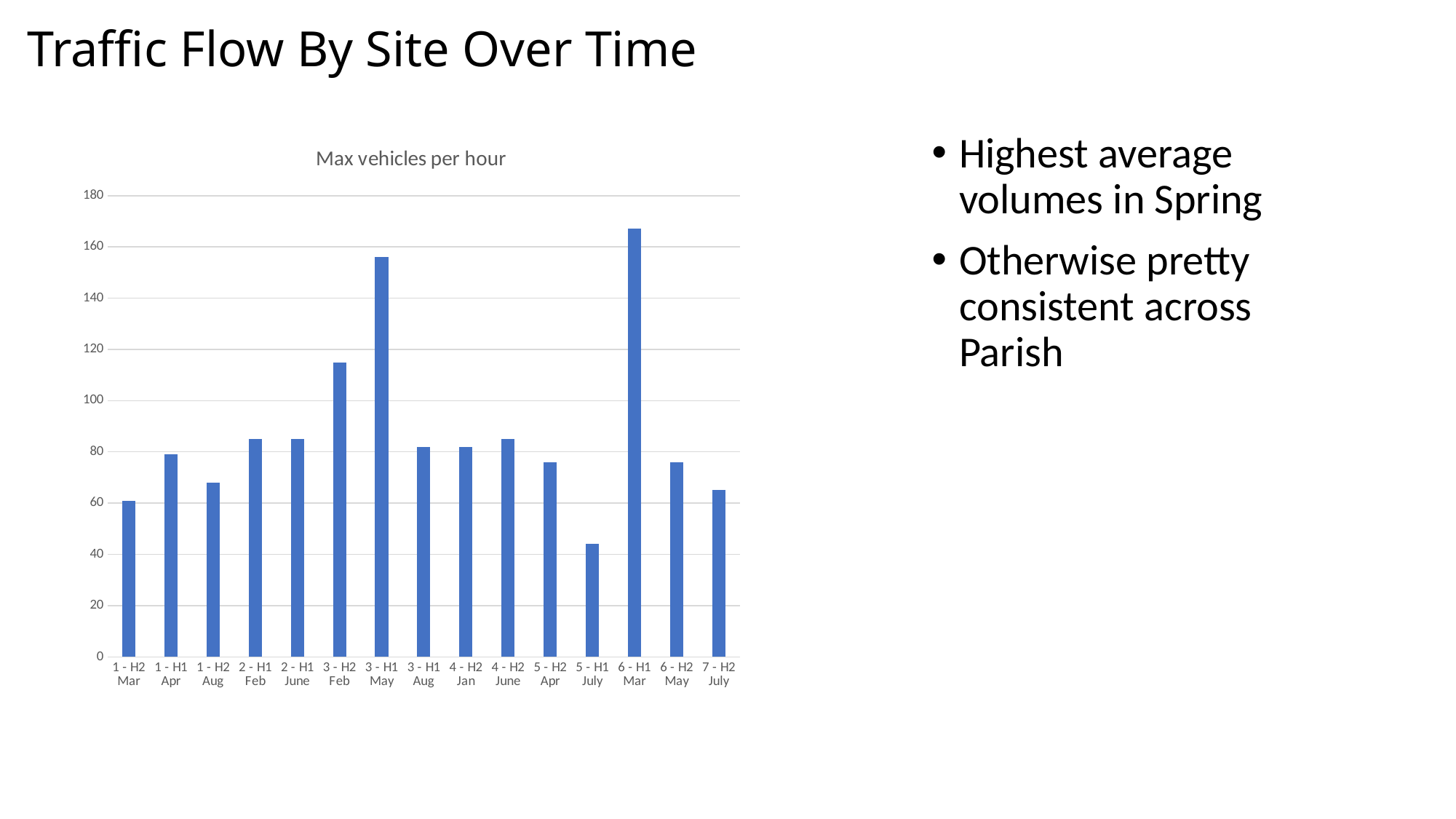
Which category has the highest value? 6 - H1 Mar Is the value for 3 - H1 May greater or less than 140? greater Is the value for 7 - H2 July greater or less than 80? less How many bars are plotted in the chart? 15 What kind of chart is shown on the slide? Bar chart Which is larger, the value for 1 - H1 Apr or the value for 1 - H2 Aug? 1 - H1 Apr What is the title of the chart? Max vehicles per hour Which is larger, the value for 3 - H1 May or the value for 3 - H2 Feb? 3 - H1 May Is the value for 3 - H2 Feb greater or less than 100? greater Which category has the lowest value? 5 - H1 July What is the highest value shown on the vertical axis? 180